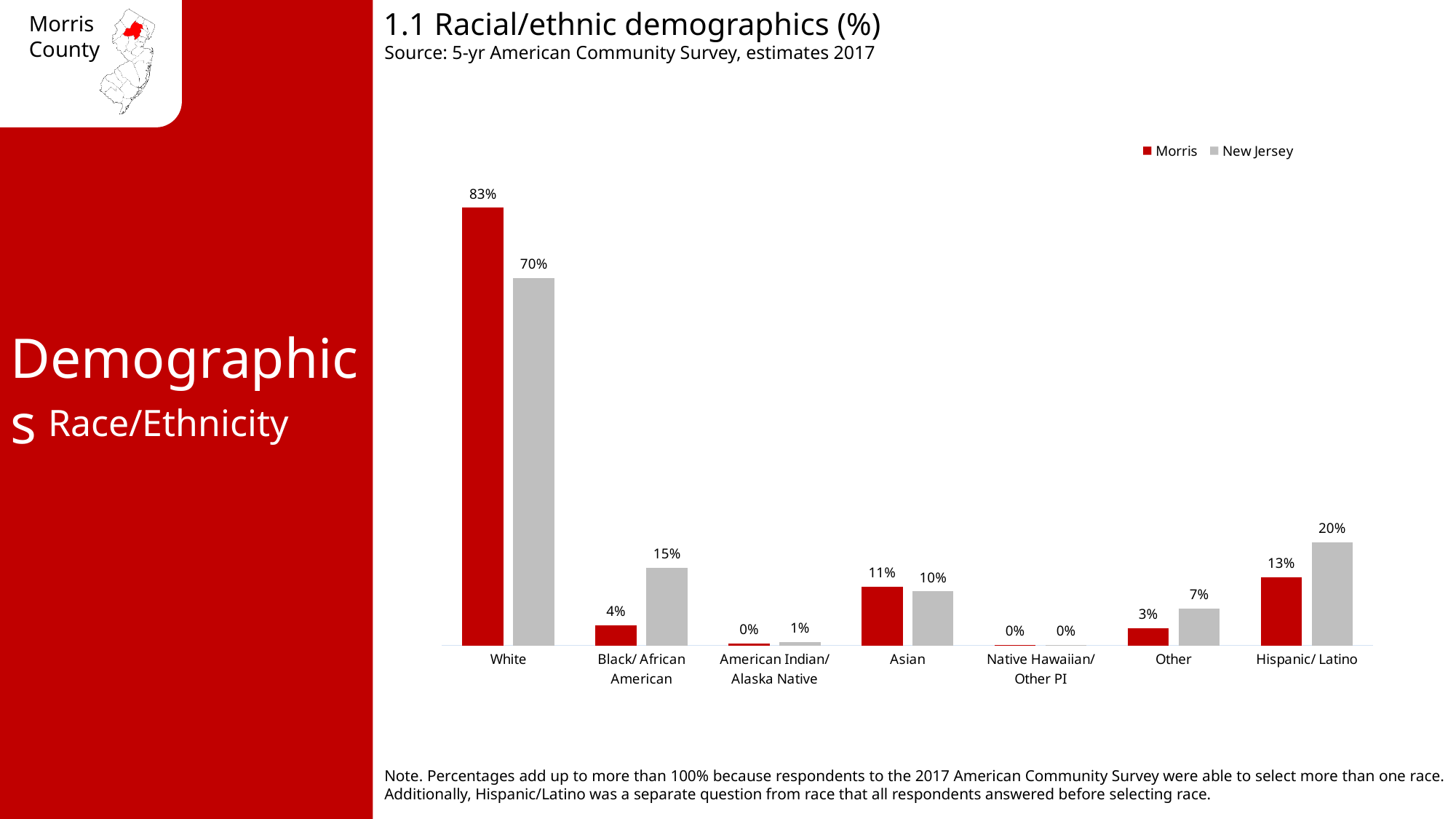
What is the Morris value for White? 83% What is the difference between the New Jersey and Morris values for Hispanic/ Latino? 7% How many racial/ethnic categories are shown on the x axis? 7 Which is larger for Other: the Morris value or the New Jersey value? New Jersey What is the New Jersey value for Hispanic/ Latino? 20% What kind of chart is shown on the slide? Bar chart How many series does the legend list? 2 What is the New Jersey value for Black/ African American? 15% Which category has the lowest New Jersey value? Native Hawaiian/ Other PI What is the Morris value for Asian? 11% What is the difference between the Morris and New Jersey values for White? 13% Which category has the highest Morris value? White